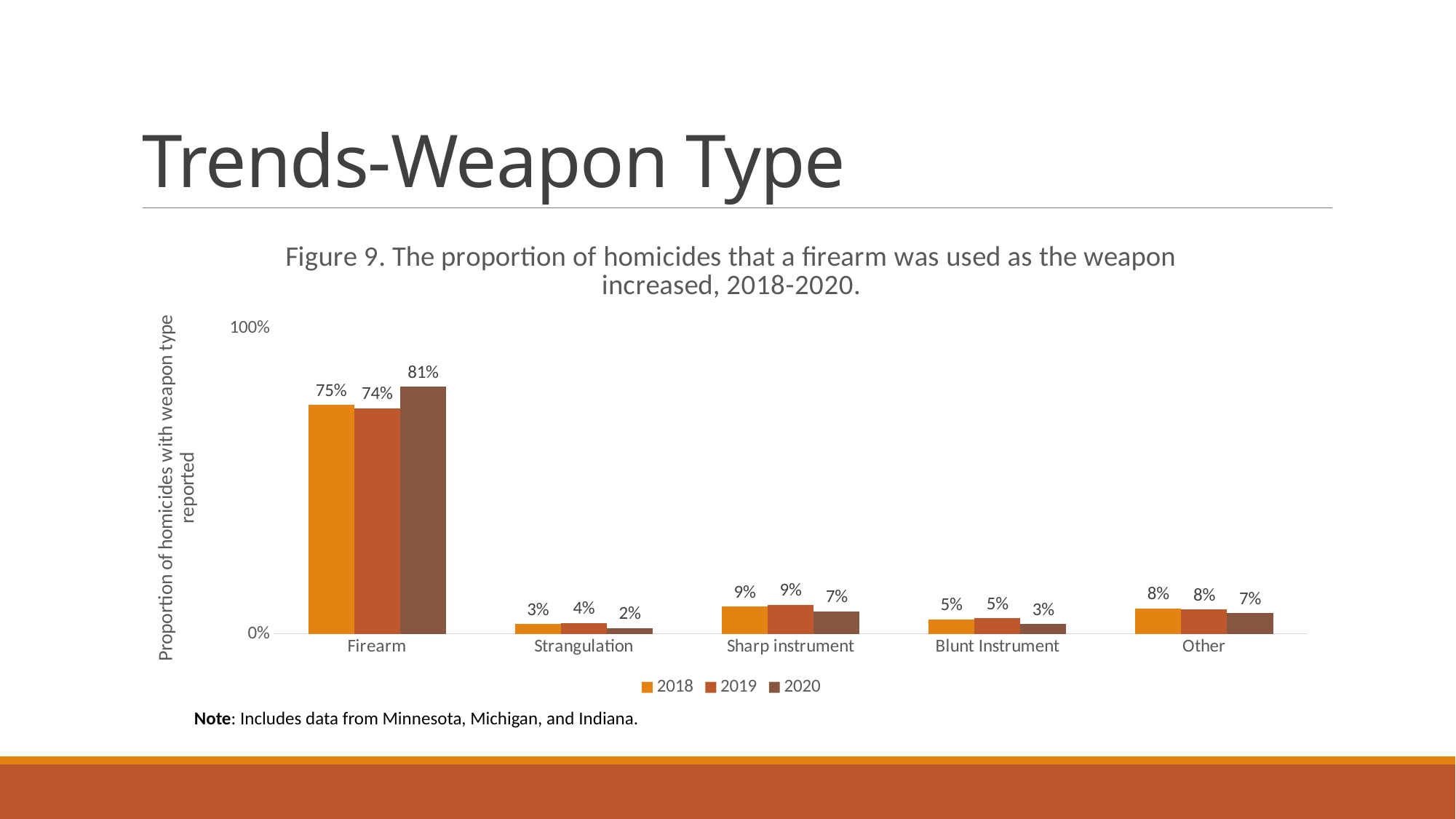
What is the y-axis label of the chart? Proportion of homicides with weapon type reported What is the difference between the Firearm values for 2020 and 2018? 6% What kind of chart is shown on the slide? Bar chart Which weapon type has the lowest value in 2020? Strangulation What is the value for Sharp instrument in 2018? 9% Which weapon type has the highest value in 2018? Firearm How many series does the legend list? 3 What is the value for Firearm in 2020? 81% What is the value for Strangulation in 2019? 4% Which is larger, the 2019 value for Other or the 2019 value for Blunt Instrument? Other What is the value for Blunt Instrument in 2020? 3% How many weapon type categories are shown on the x axis? 5